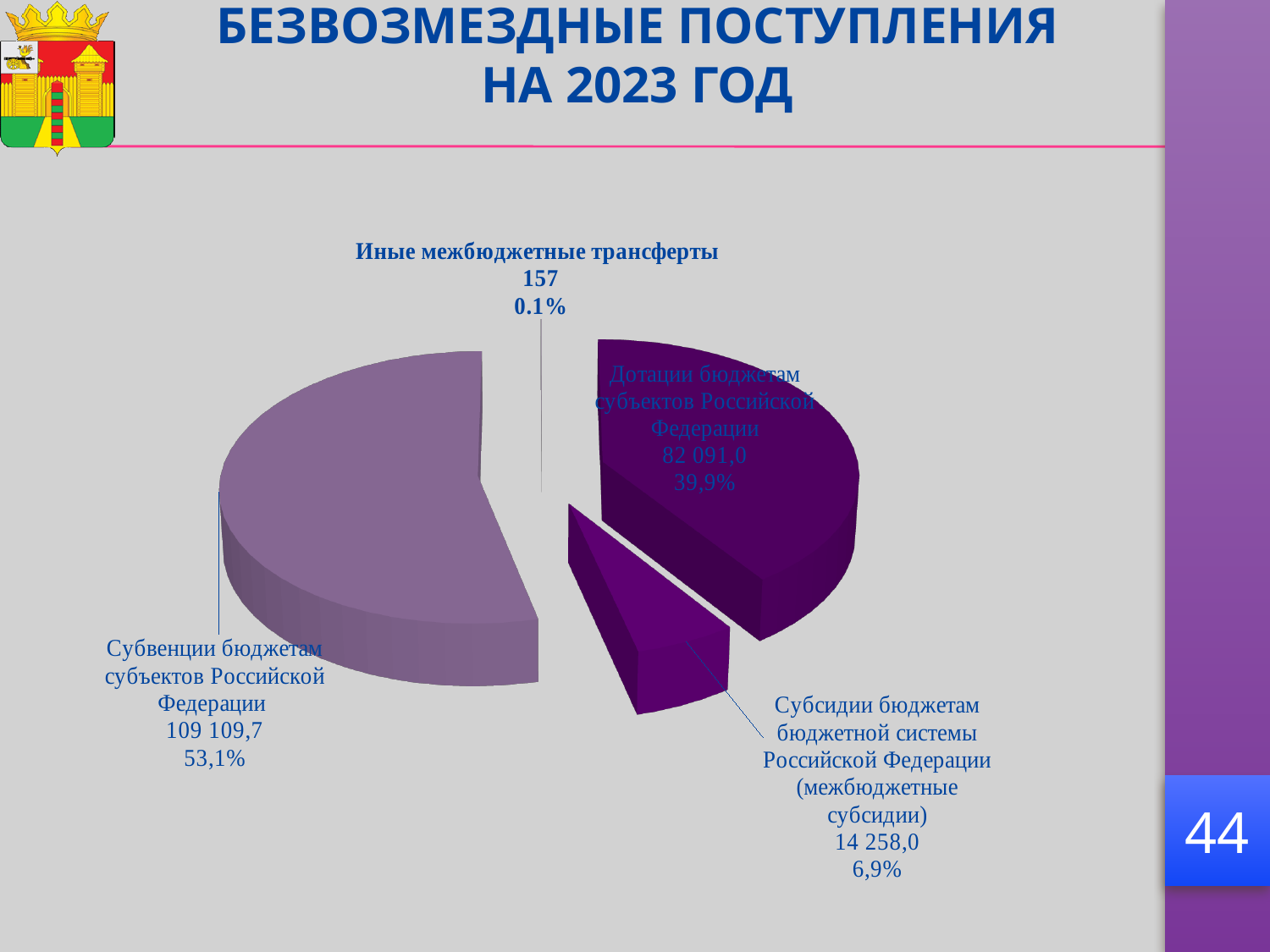
What is the value for Иные межбюджетные трансферты? 157 What is the value for Дотации бюджетам субъектов Российской Федерации? 82 091,0 Which category has the largest slice of the pie? Субвенции бюджетам субъектов Российской Федерации What share of the pie does Субсидии бюджетам бюджетной системы Российской Федерации (межбюджетные субсидии) represent? 6,9% What kind of chart is shown on the slide? Pie chart How many slices does the pie chart have? 4 What is the title of the slide containing the chart? БЕЗВОЗМЕЗДНЫЕ ПОСТУПЛЕНИЯ НА 2023 ГОД What is the value for Субвенции бюджетам субъектов Российской Федерации? 109 109,7 What is the value for Субсидии бюджетам бюджетной системы Российской Федерации (межбюджетные субсидии)? 14 258,0 What share of the pie does Субвенции бюджетам субъектов Российской Федерации represent? 53,1% Which category has the smallest slice of the pie? Иные межбюджетные трансферты Which is larger: Дотации бюджетам субъектов Российской Федерации or Субсидии бюджетам бюджетной системы Российской Федерации (межбюджетные субсидии)? Дотации бюджетам субъектов Российской Федерации